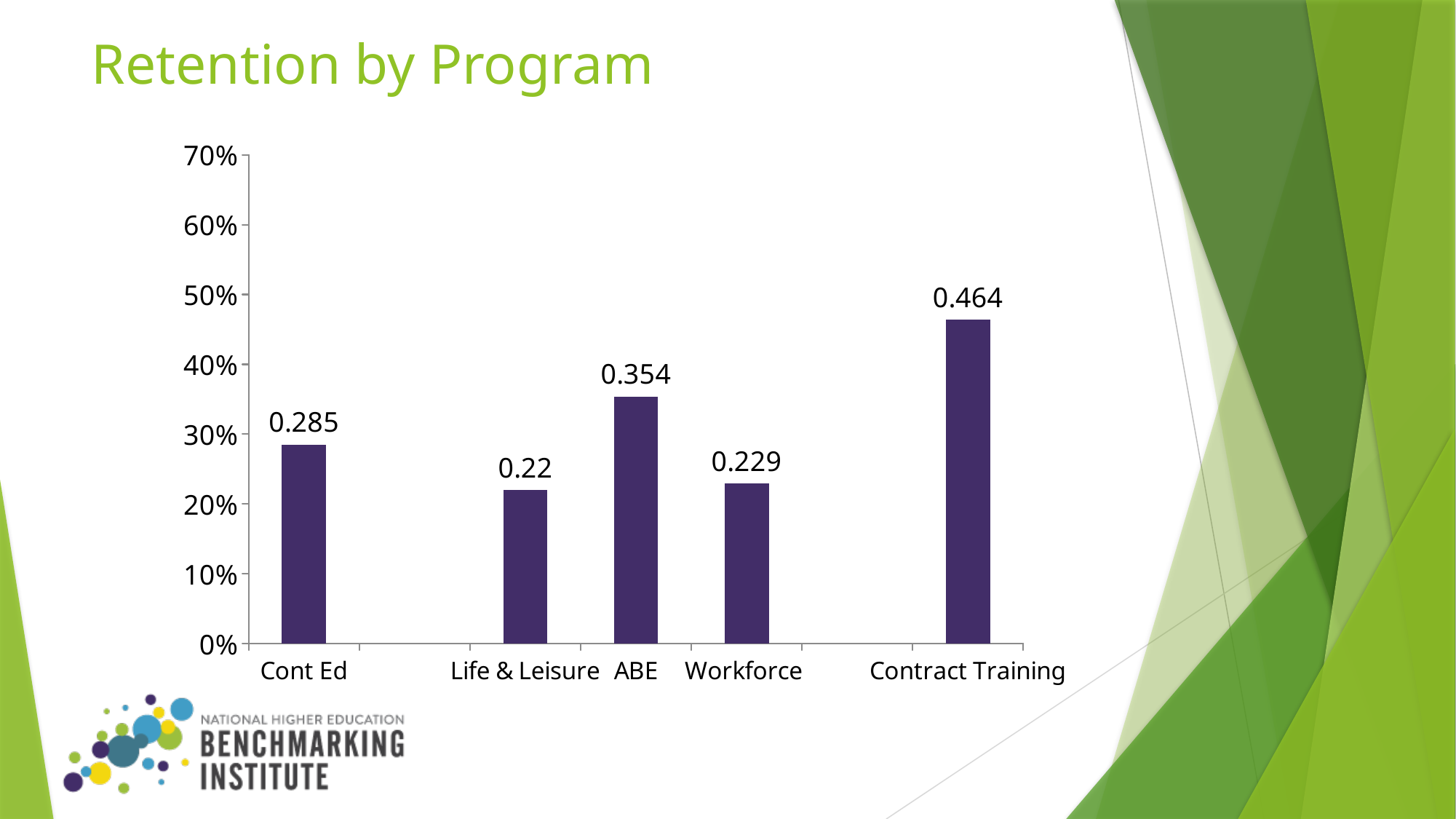
What is the retention value shown for Contract Training? 0.464 Which program has the highest retention? Contract Training What is the retention value shown for Life & Leisure? 0.22 What kind of chart is shown on the slide? Bar chart Is the value for ABE greater or less than 30%? greater How many programs are shown on the chart? 5 What is the retention value shown for Cont Ed? 0.285 What is the difference between the values for Contract Training and ABE? 0.11 What is the retention value shown for ABE? 0.354 Which has a higher retention value, Cont Ed or Workforce? Cont Ed Which program has the lowest retention? Life & Leisure What is the title of the slide? Retention by Program